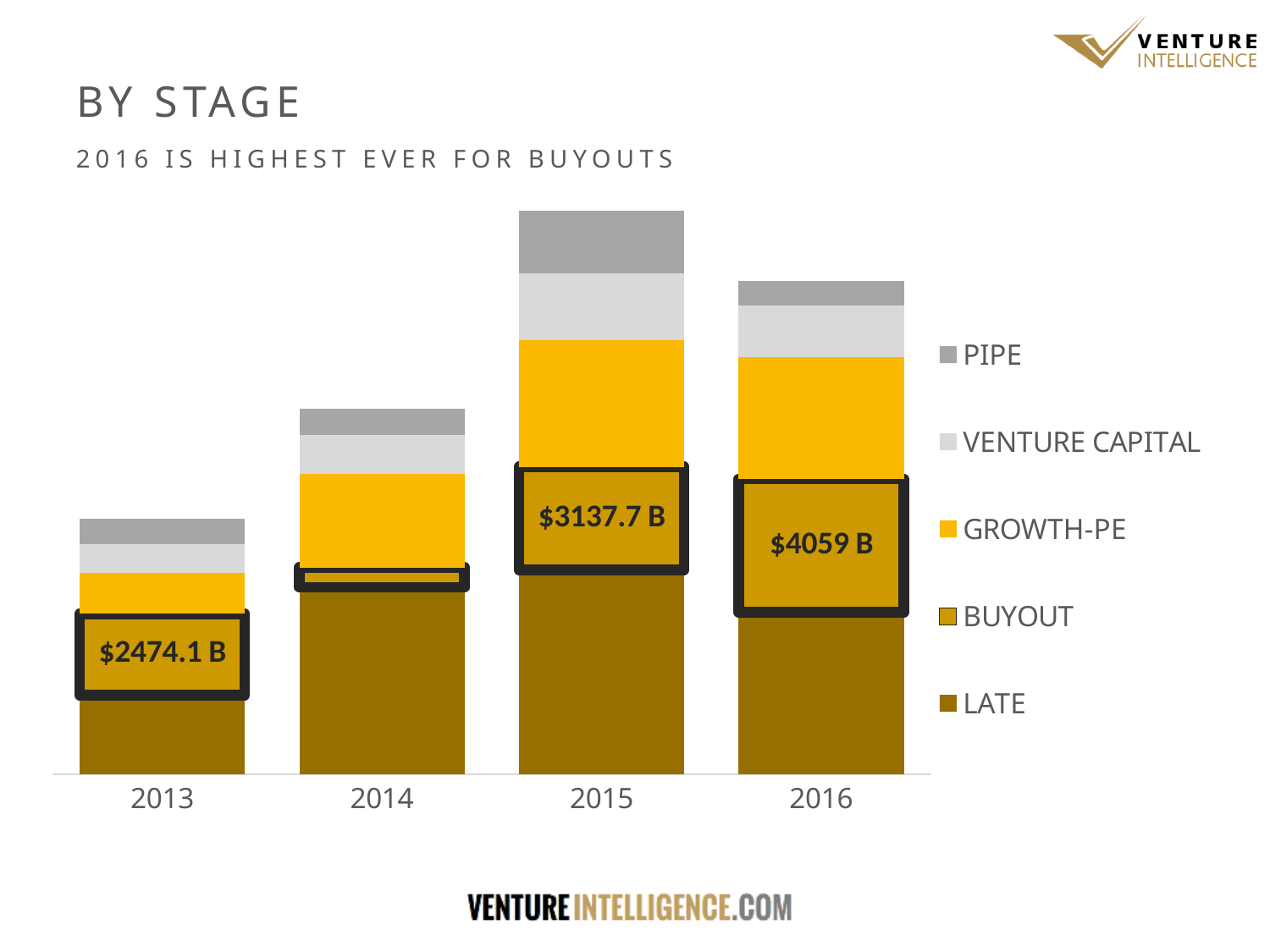
Which year has the lowest BUYOUT value? 2014 How many series does the legend list? 5 What is the BUYOUT value for 2015? $3137.7 B What is the difference between the BUYOUT values for 2015 and 2013? $663.6 B Which is larger, the BUYOUT value for 2013 or for 2015? 2015 What is the BUYOUT value for 2013? $2474.1 B What is the BUYOUT value for 2016? $4059 B What is the difference between the BUYOUT values for 2016 and 2015? $921.3 B Which year has the tallest total stacked bar? 2015 How many years are shown on the x axis? 4 What kind of chart is shown on the slide? Stacked bar chart Which year has the highest BUYOUT value? 2016